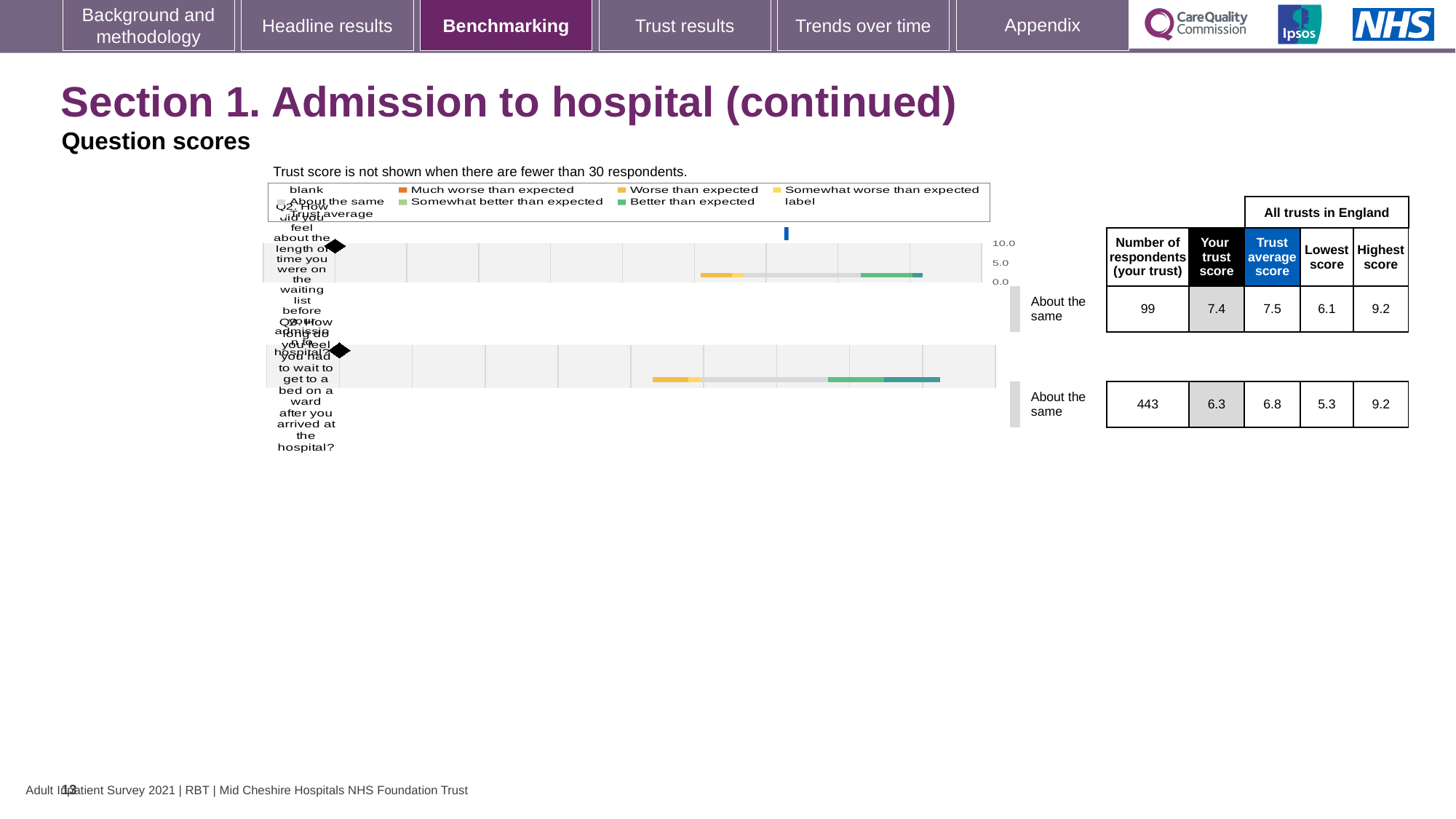
What is the trust score for Q2 (how did you feel about the length of time you were on the waiting list before admission)? 7.4 What is the trust score for Q3 (how long did you feel you had to wait to get to a bed on a ward after you arrived at the hospital)? 6.3 What is the trust average score across all trusts in England for Q3? 6.8 How many questions are plotted on the chart? 2 What is the difference between the highest and lowest scores across all trusts in England for Q2? 3.1 How many respondents from the trust answered Q2? 99 What is the lowest score among all trusts in England for Q3? 5.3 How many respondents from the trust answered Q3? 443 What benchmark rating is shown for both Q2 and Q3? About the same What is the highest score among all trusts in England for Q2? 9.2 What is the difference between the trust average score and this trust's score for Q3? 0.5 Which question has the higher trust score, Q2 or Q3? Q2